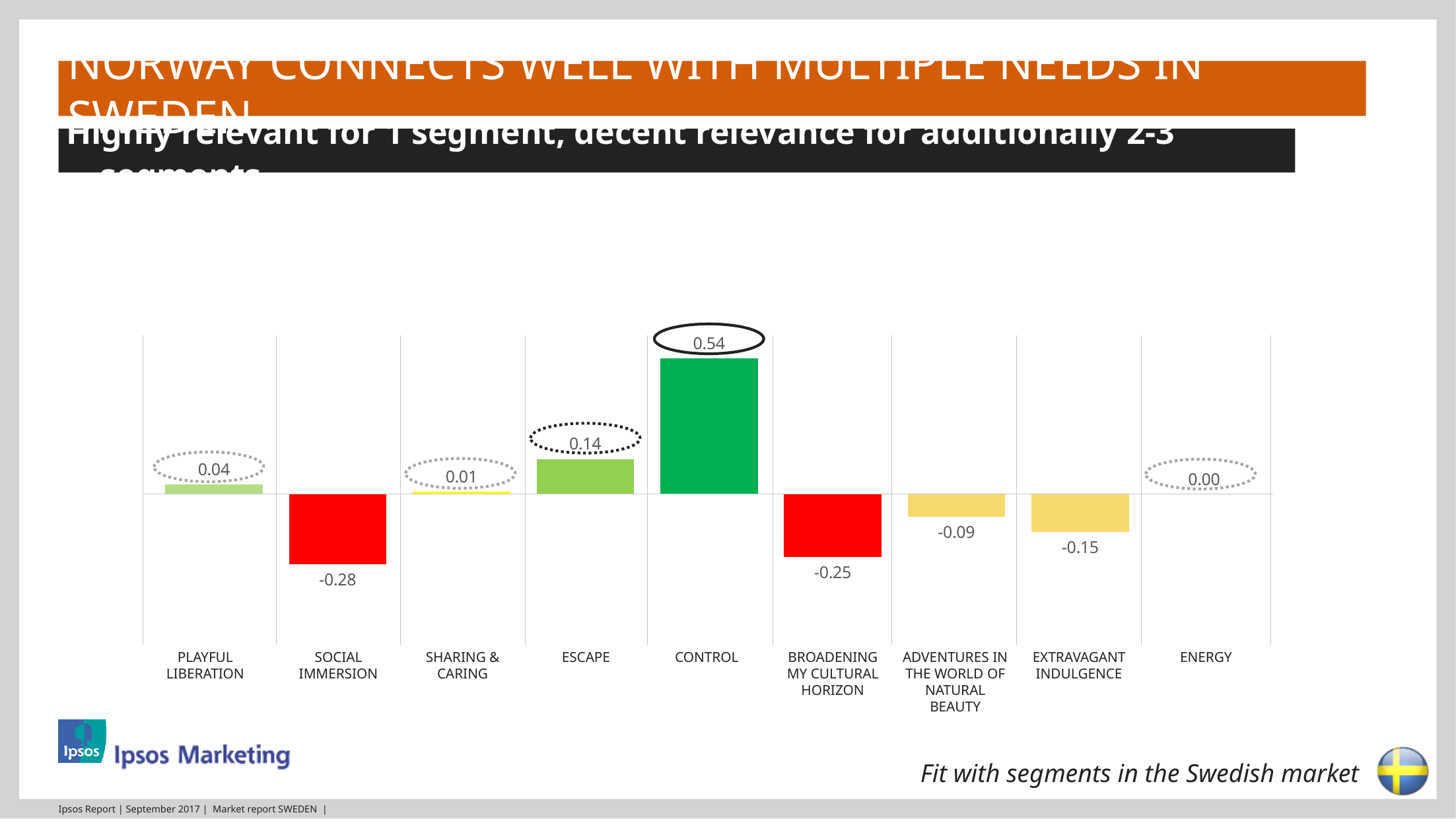
Which category has the highest value? CONTROL Which is larger, the value for PLAYFUL LIBERATION or the value for SHARING & CARING? PLAYFUL LIBERATION What is the difference between the values for CONTROL and ESCAPE? 0.40 How many categories are shown on the x axis? 9 What kind of chart is shown on the slide? Bar chart Which category has the lowest value? SOCIAL IMMERSION What is the value for SOCIAL IMMERSION? -0.28 What colour is the bar for CONTROL? Green What is the value for EXTRAVAGANT INDULGENCE? -0.15 What is the value for CONTROL? 0.54 What is the value for ESCAPE? 0.14 What is the value for ENERGY? 0.00